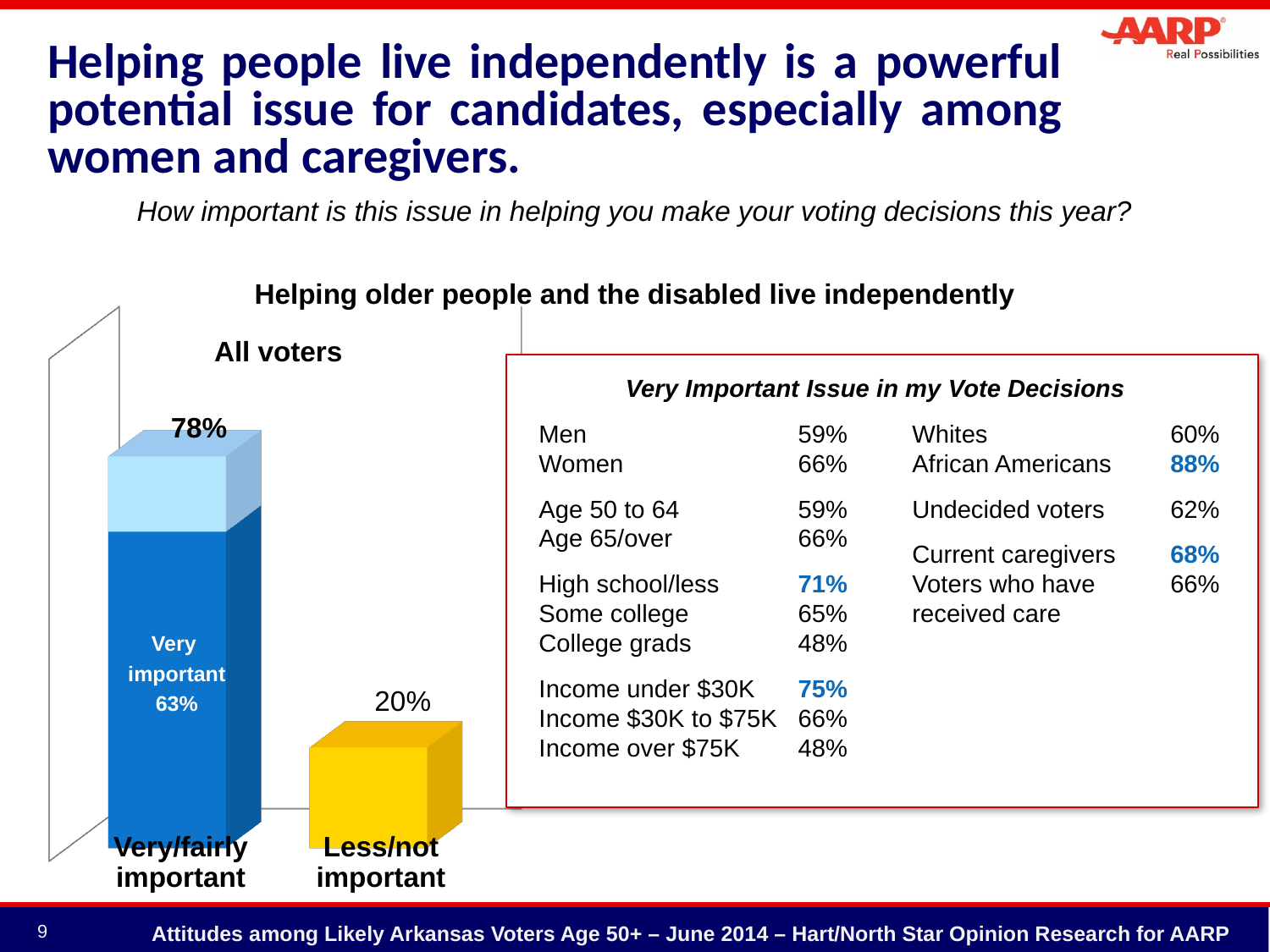
What percentage of all voters say the issue is "Very important", as labeled inside the bar? 63% Which category has the highest value in the chart? Very/fairly important Which group of respondents does the chart represent, according to the label above the bars? All voters What is the total of the stacked "Very/fairly important" bar? 78% What is the title of the chart? Helping older people and the disabled live independently How many categories are shown on the x axis of the chart? 2 Which category has the lowest value in the chart? Less/not important What is the total value shown for the "Very/fairly important" bar? 78% Which is larger: the "Very/fairly important" bar or the "Less/not important" bar? Very/fairly important What kind of chart is shown on the slide? Bar chart What is the value shown for the "Less/not important" bar? 20% What is the difference in percentage points between the "Very/fairly important" bar (78%) and the "Less/not important" bar (20%)? 58 percentage points